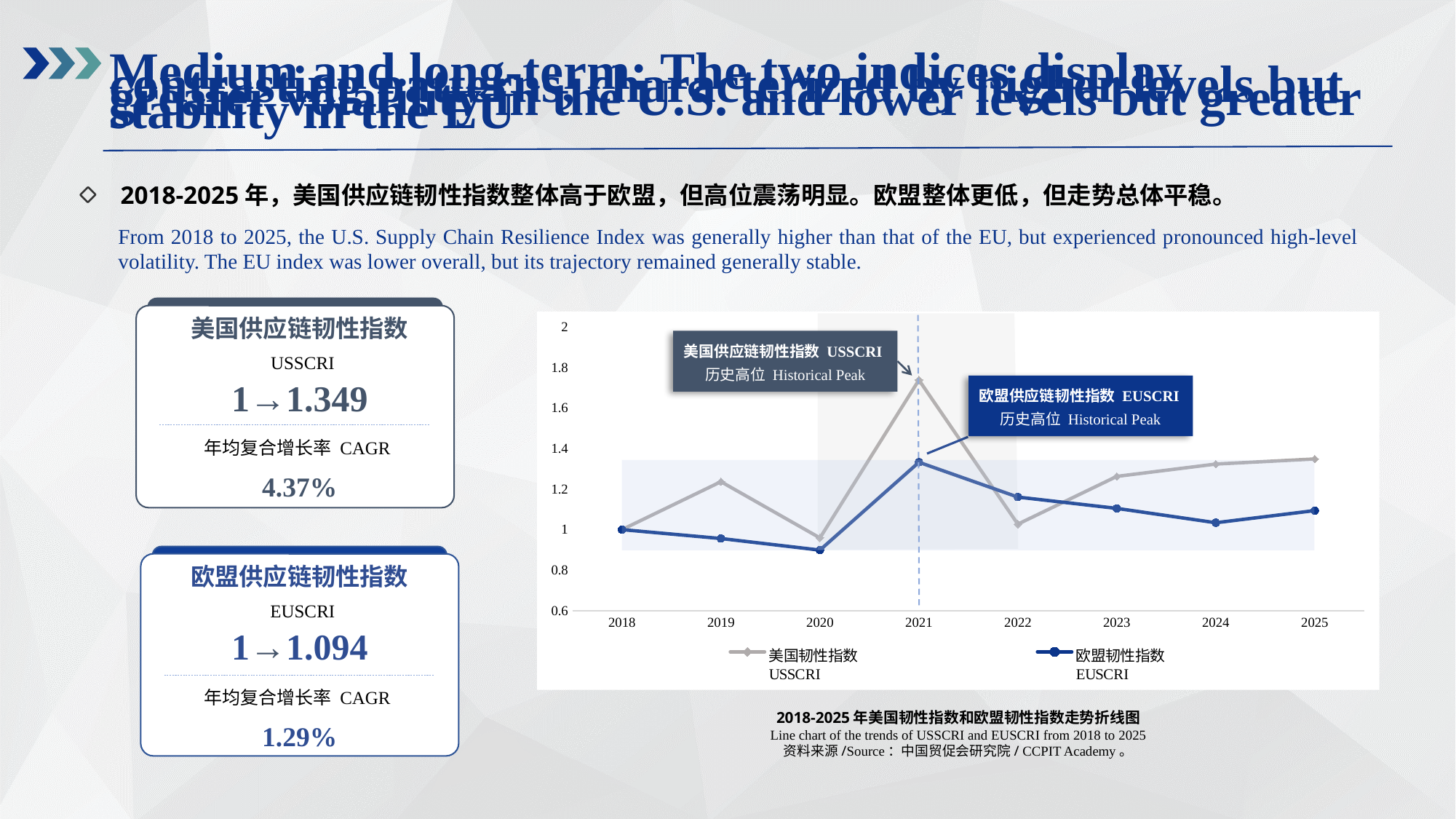
Is the EUSCRI value for 2020 greater or less than 1? less Is the USSCRI value for 2021 greater or less than 1.6? greater How many years are plotted along the x axis of the chart? 8 Does the USSCRI series rise or fall from 2022 to 2025? Rise In 2022, which series has the larger value, USSCRI or EUSCRI? EUSCRI In which year does the EUSCRI series reach its highest value? 2021 How many series does the chart's legend list? 2 In which year does the USSCRI series reach its highest value? 2021 Is the EUSCRI value for 2024 greater or less than 1.2? less In which year does the EUSCRI series reach its lowest value? 2020 What kind of chart is shown on the slide? Line chart What is the value of both USSCRI and EUSCRI in 2018? 1